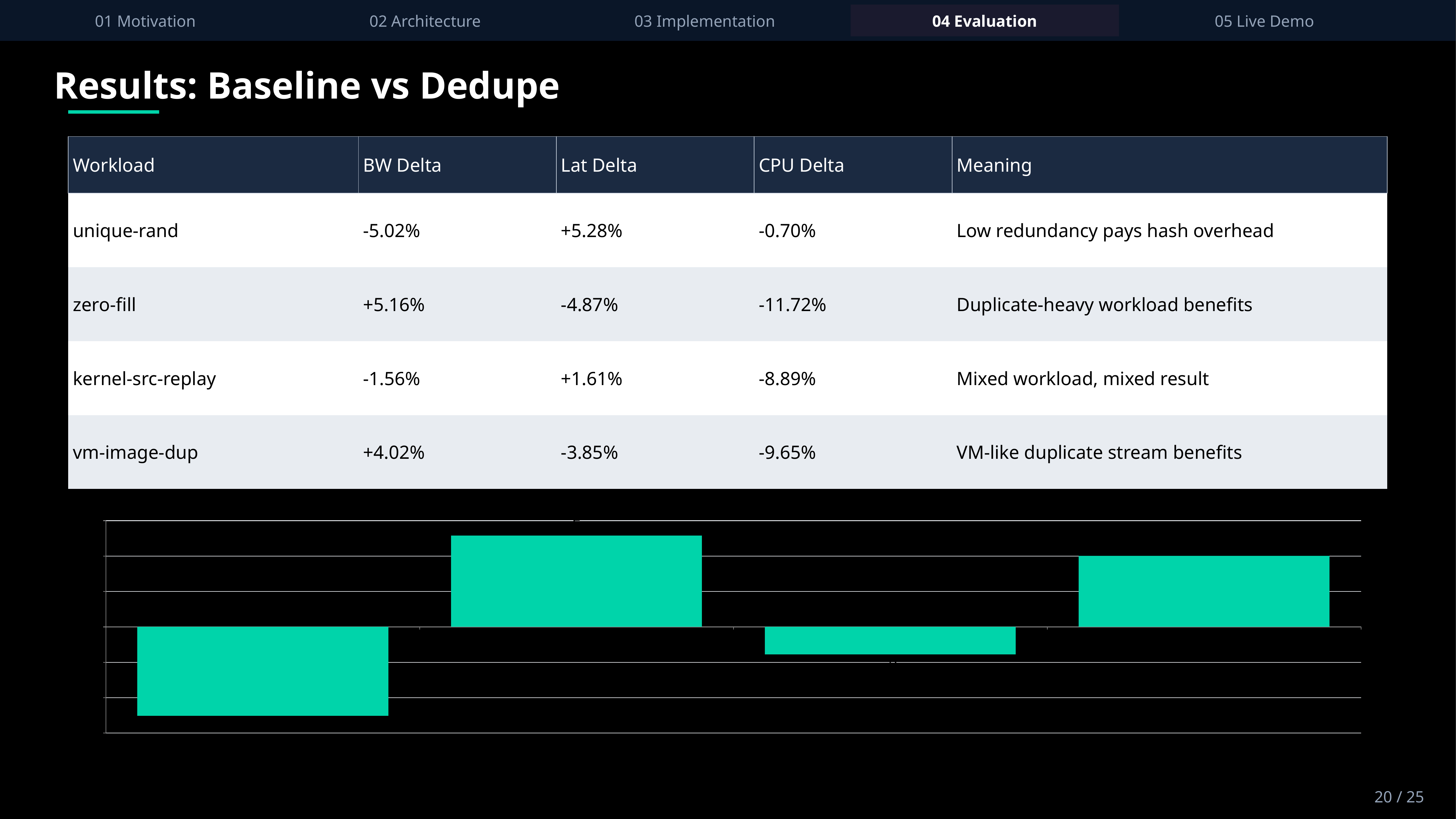
In the chart at the bottom of the slide, which bar (counting from the left) extends furthest above the baseline? the second bar What kind of chart is shown at the bottom of the slide? bar chart In the chart at the bottom of the slide, is the second bar from the left taller than the third bar from the left? yes What colour are the bars in the chart at the bottom of the slide? teal/green How many bars does the chart at the bottom of the slide contain? 4 In the chart at the bottom of the slide, which bar (counting from the left) is the shortest? the third bar